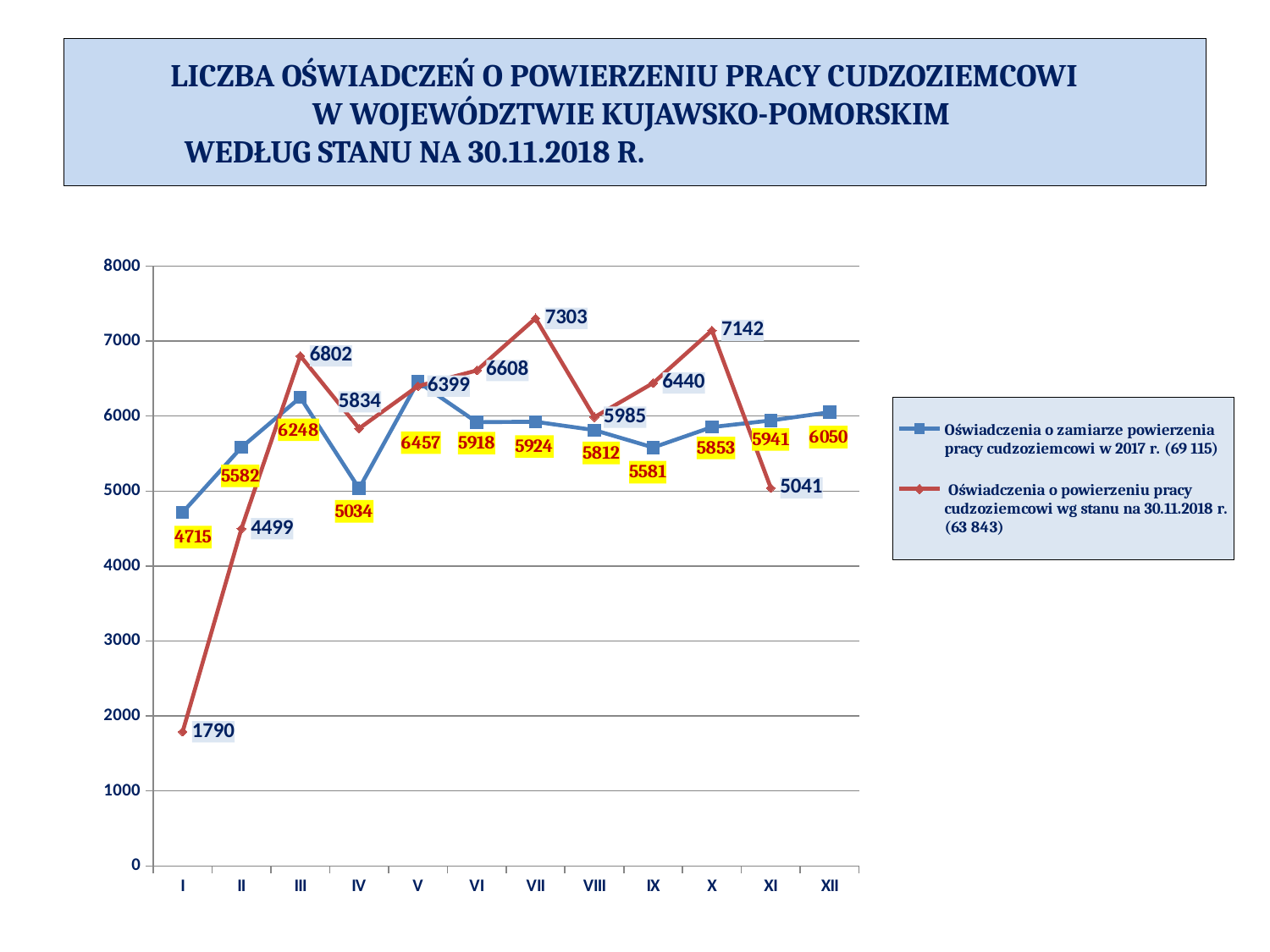
How many series does the legend list? 2 What is the value for month XI in the 2018 series? 5041 How many months are shown on the x axis? 12 What is the value for month I in the 2017 series (Oświadczenia o zamiarze powierzenia pracy cudzoziemcowi w 2017 r.)? 4715 What is the difference between the 2018 and 2017 values in month VII? 1379 In which month is the 2017 series highest? V In month X, which series has the larger value, 2017 or 2018? 2018 What kind of chart is shown on the slide? line chart In which month is the 2018 series lowest? I What total is given in the legend for the 2017 series? 69 115 What is the value for month VII in the 2018 series (Oświadczenia o powierzeniu pracy cudzoziemcowi wg stanu na 30.11.2018 r.)? 7303 In which month is the 2018 series highest? VII